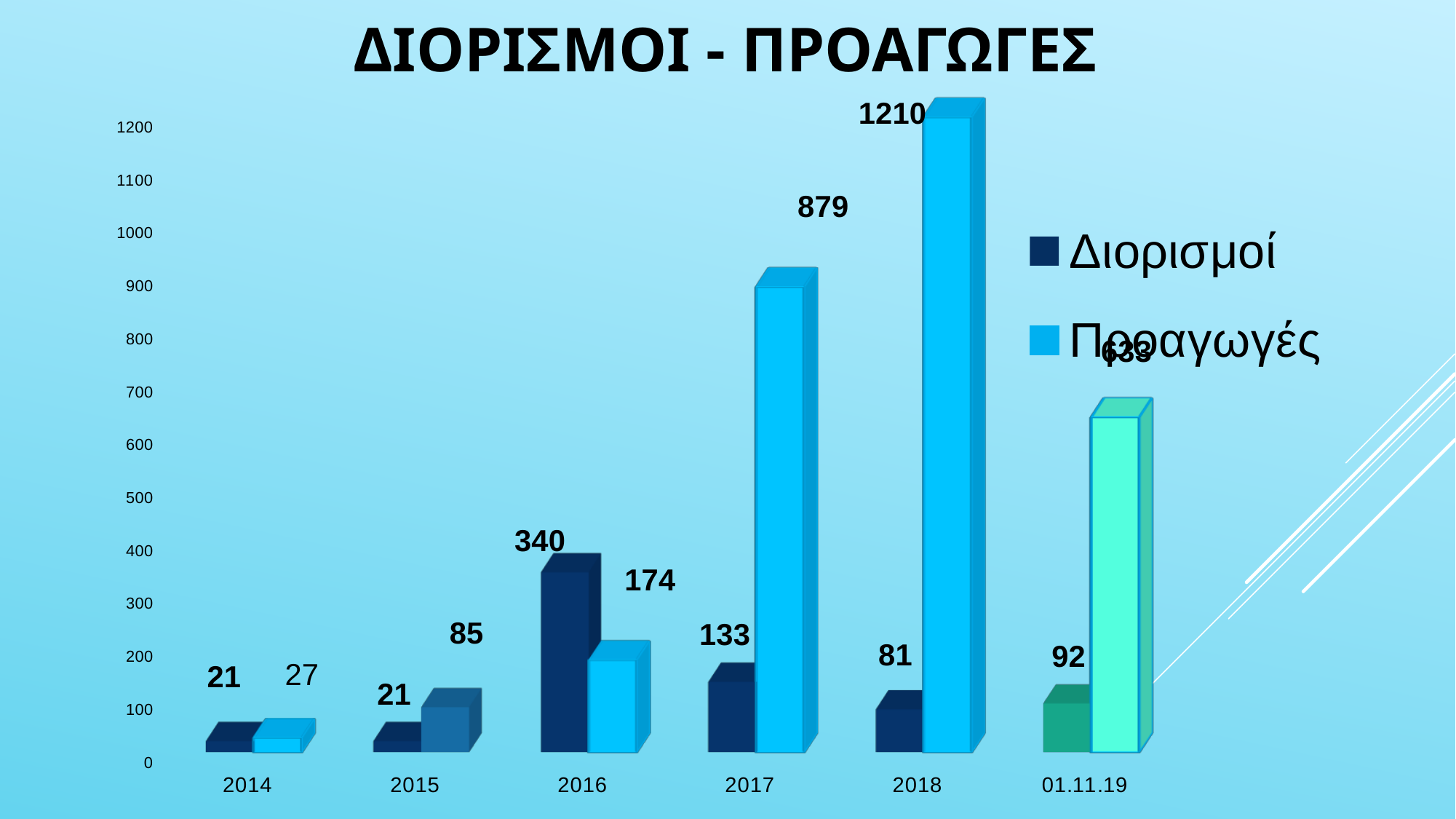
What is the value for Διορισμοί in 2016? 340 How many categories are shown on the x axis? 6 Which year has the highest value for Προαγωγές? 2018 Which category has the highest value for Διορισμοί? 2016 Is the value for Προαγωγές at 01.11.19 greater or less than 500? greater What is the value for Διορισμοί in 2018? 81 Which is larger in 2016, Διορισμοί or Προαγωγές? Διορισμοί What is the value for Προαγωγές in 2017? 879 What is the difference between Προαγωγές and Διορισμοί in 2017? 746 What is the value for Προαγωγές in 2018? 1210 How many series does the legend list? 2 What is the title of the chart? ΔΙΟΡΙΣΜΟΙ - ΠΡΟΑΓΩΓΕΣ